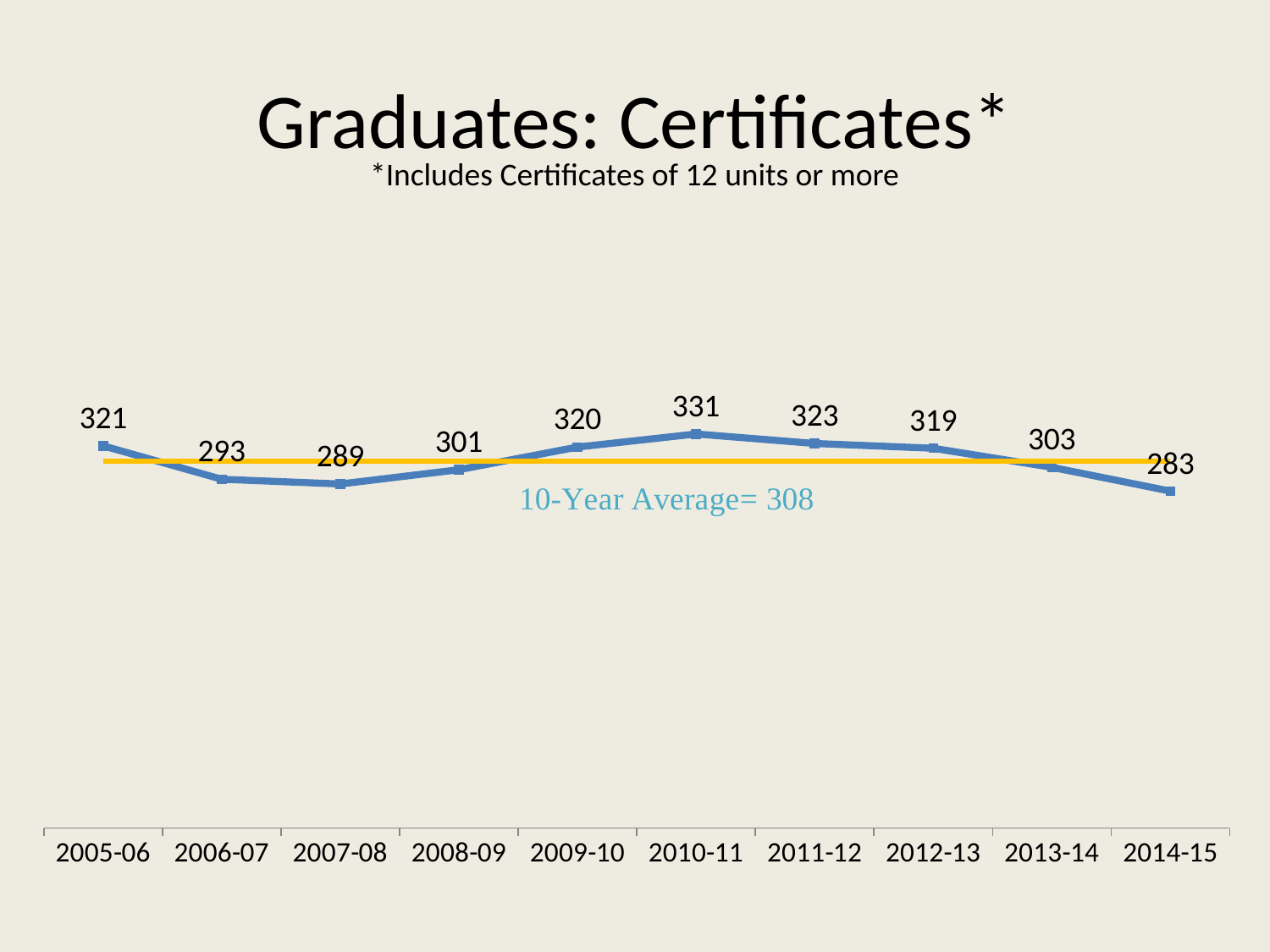
Do the values rise or fall from 2010-11 to 2014-15? fall What is the 10-year average shown on the chart? 308 Which is larger, the value for 2009-10 or the value for 2013-14? 2009-10 What is the value for 2010-11? 331 What is the difference between the values for 2010-11 and 2014-15? 48 Which year has the highest value? 2010-11 Which year has the lowest value? 2014-15 How many years are plotted on the x axis? 10 What is the difference between the values for 2005-06 and 2006-07? 28 What kind of chart is shown on the slide? line chart What is the value for 2014-15? 283 What is the value for 2007-08? 289